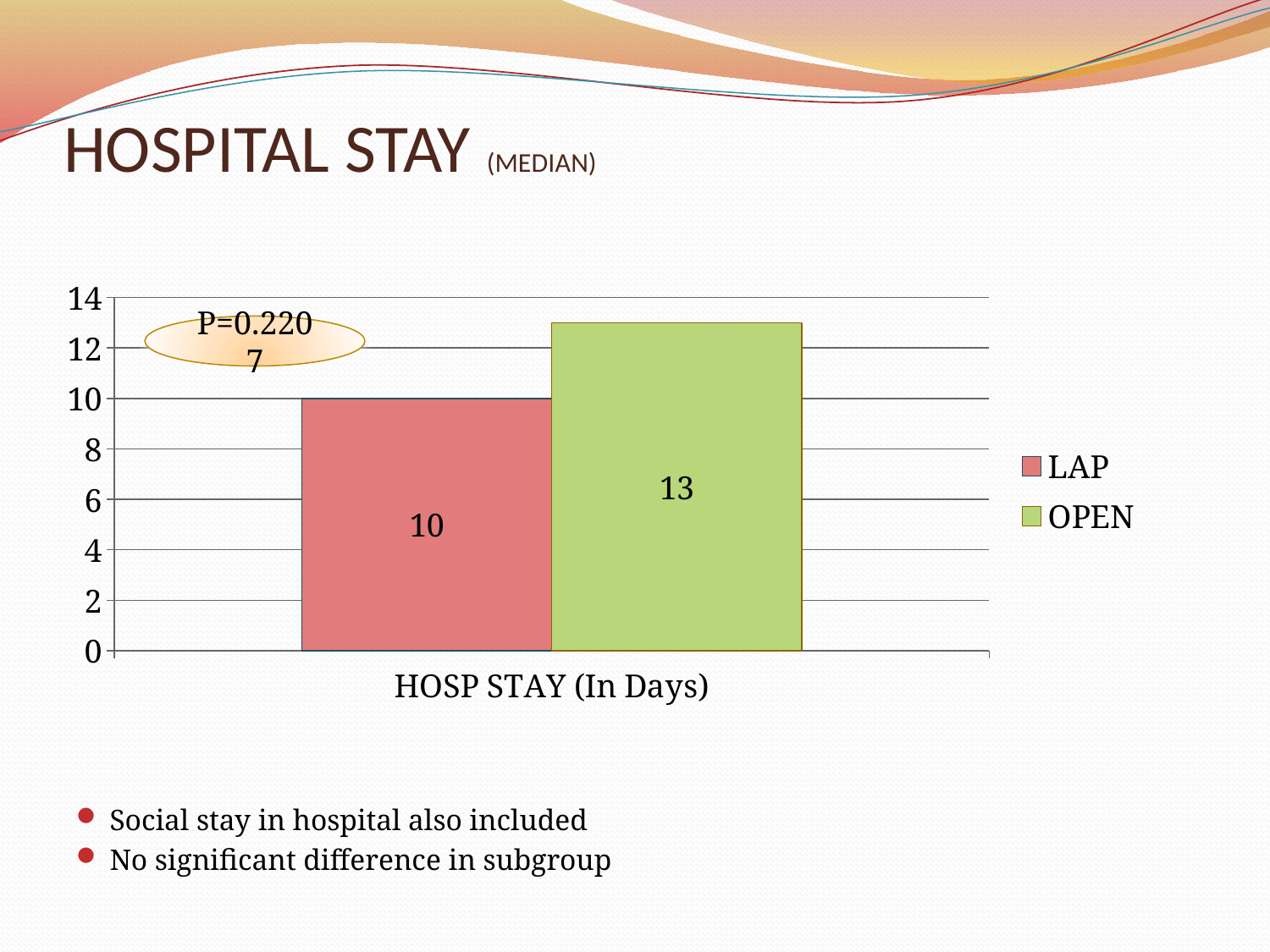
What is the maximum value shown on the y axis? 14 Which series has the lowest value in the chart? LAP What P value is shown on the chart? P=0.220 What is the value for LAP in the hospital stay chart? 10 How many series does the legend list? 2 Which series has the higher hospital stay value, LAP or OPEN? OPEN What is the label on the x axis of the chart? HOSP STAY (In Days) What is the value for OPEN in the hospital stay chart? 13 Is the value for LAP greater or less than 12? less What is the difference between the OPEN and LAP values? 3 Is the value for OPEN greater or less than 12? greater What kind of chart is shown on the slide? bar chart